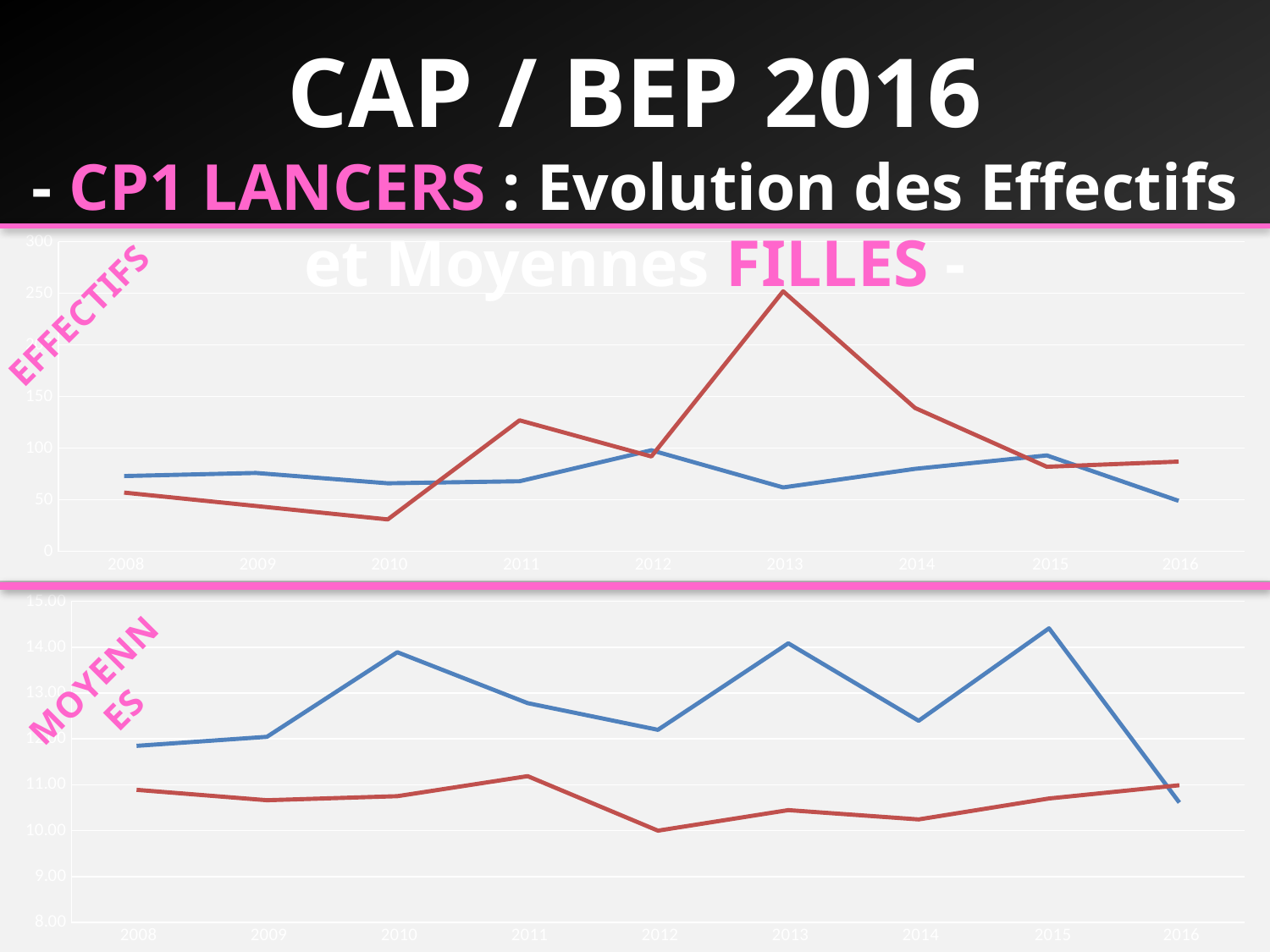
In the bottom chart (MOYENNES), in which year does the red line reach its lowest value? 2012 In the top chart (EFFECTIFS), in which year does the blue line reach its lowest value? 2016 What kind of chart is the bottom chart (MOYENNES)? line chart In the top chart (EFFECTIFS), which line is higher in 2013, the red line or the blue line? the red line In the top chart (EFFECTIFS), in which year does the red line reach its highest value? 2013 What kind of chart is the top chart (EFFECTIFS)? line chart In the bottom chart (MOYENNES), how many lines are plotted? 2 In the bottom chart (MOYENNES), does the blue line rise or fall from 2015 to 2016? fall In the bottom chart (MOYENNES), is the blue line's value for 2015 greater or less than 14.00? greater In the top chart (EFFECTIFS), is the red line's value for 2013 greater or less than 200? greater In the top chart (EFFECTIFS), how many years are shown on the x axis? 9 In the top chart (EFFECTIFS), in which year does the red line reach its lowest value? 2010